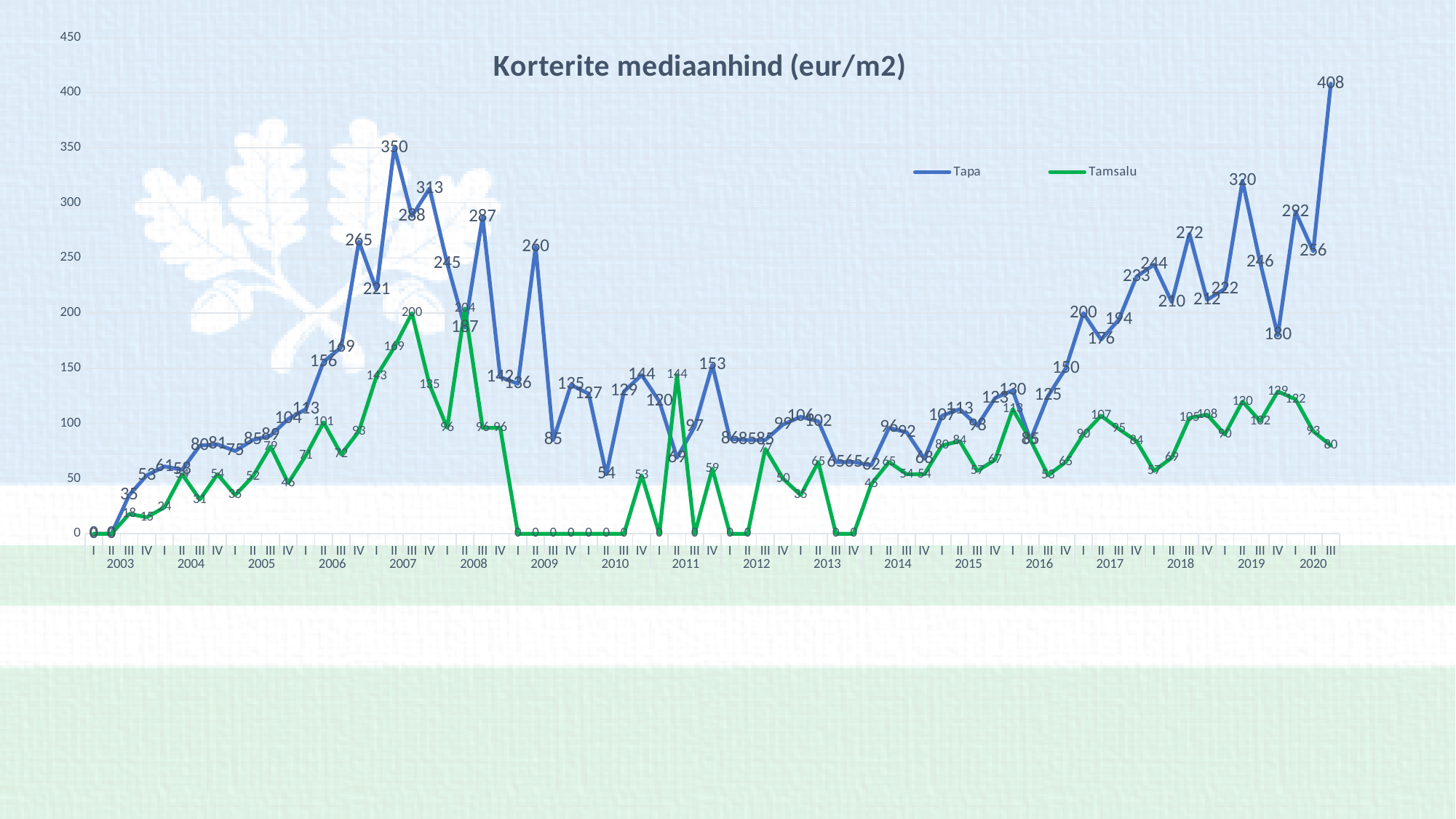
How many series does the legend list? 2 What is the value for Tamsalu in quarter II of 2009? 0 What is the highest value reached by the Tapa series? 408 What is the value for Tapa in quarter II of 2009? 260 What is the value for Tapa in quarter II of 2007? 350 What type of chart is shown on the slide? line chart Which series is drawn in green? Tamsalu What is the value for Tapa in quarter IV of 2007? 313 Does the Tapa series generally rise or fall from 2016 to 2020? rise Is the value for Tapa in quarter III of 2020 greater or less than 400? greater What is the title of the chart? Korterite mediaanhind (eur/m2) In quarter II of 2007, which series has the larger value, Tapa or Tamsalu? Tapa